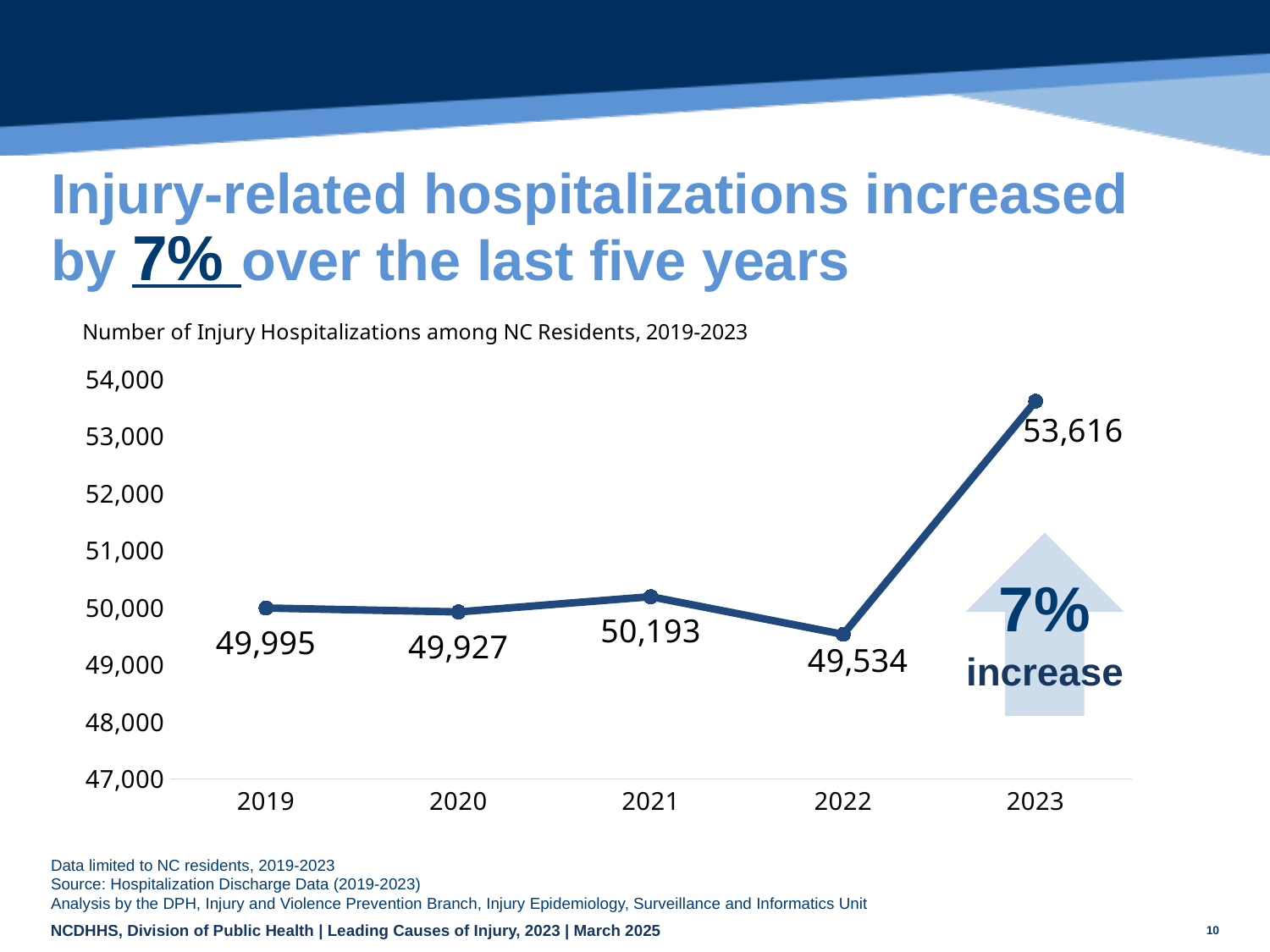
Did injury hospitalizations rise or fall from 2022 to 2023? Rise What kind of chart is shown on the slide? Line chart What is the difference in injury hospitalizations between 2023 and 2022? 4,082 What was the number of injury hospitalizations in 2023? 53,616 What is the title of the chart? Number of Injury Hospitalizations among NC Residents, 2019-2023 Is the value for 2022 greater or less than 50,000? less Which year had the highest number of injury hospitalizations? 2023 Which year had more injury hospitalizations, 2019 or 2020? 2019 What was the number of injury hospitalizations in 2021? 50,193 Which year had the lowest number of injury hospitalizations? 2022 What was the number of injury hospitalizations among NC residents in 2019? 49,995 How many years are plotted on the chart? 5